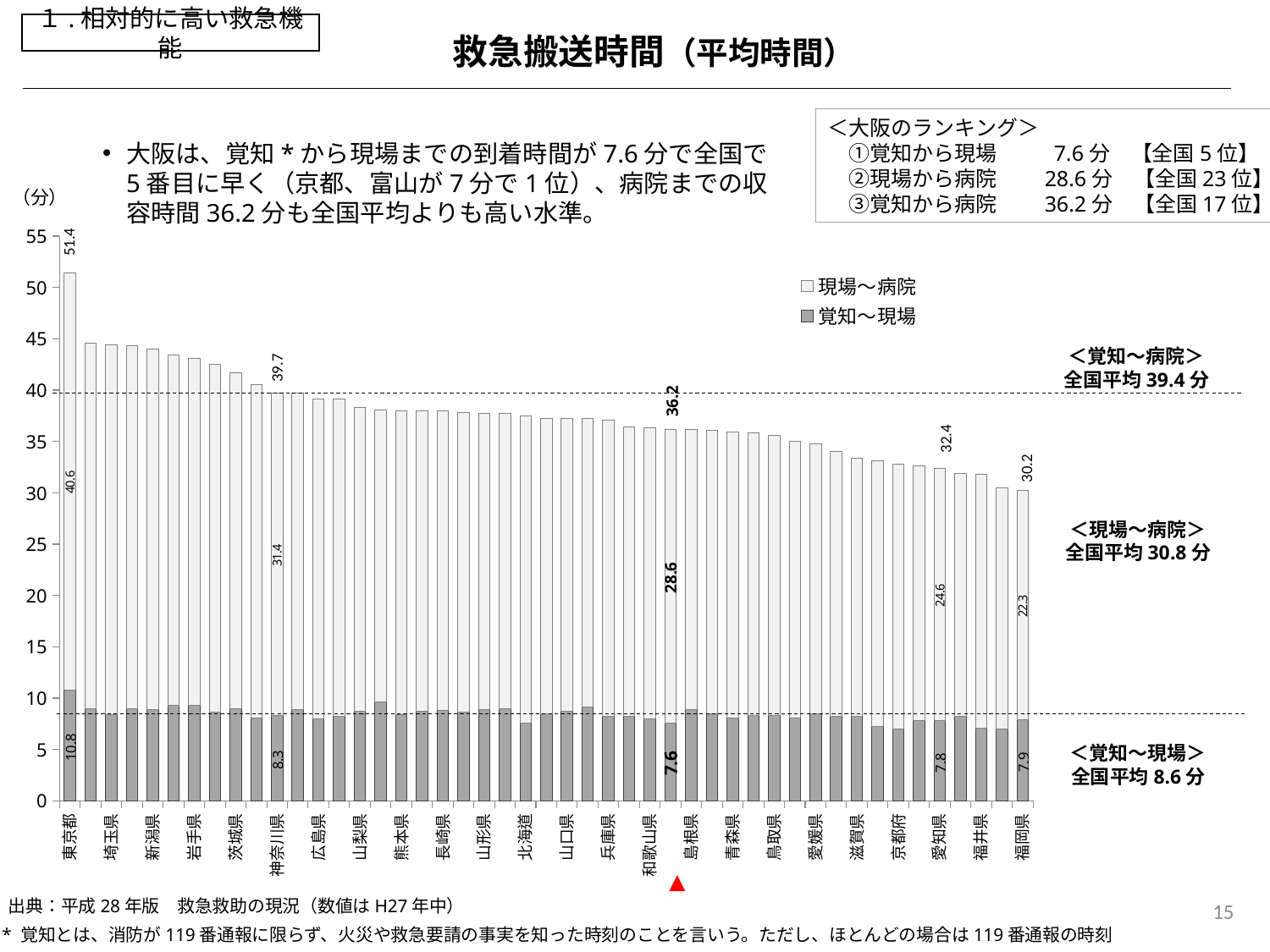
Do the total bar heights rise or fall from left to right along the x axis? fall Which prefecture has the highest total bar? 東京都 What is the total value labelled for 福岡県? 30.2 What is the total (覚知～病院) value labelled for 神奈川県? 39.7 What is the difference between the total values of 東京都 (51.4) and 福岡県 (30.2)? 21.2 What is the 現場～病院 value for 東京都? 40.6 Is the total value for 東京都 greater or less than 50? greater What is the 現場～病院 value for 愛知県? 24.6 Which has the larger total bar, 東京都 or 神奈川県? 東京都 What type of chart is shown on the slide? Stacked bar chart What is the 覚知～現場 value for 東京都? 10.8 How many series does the chart legend list? 2